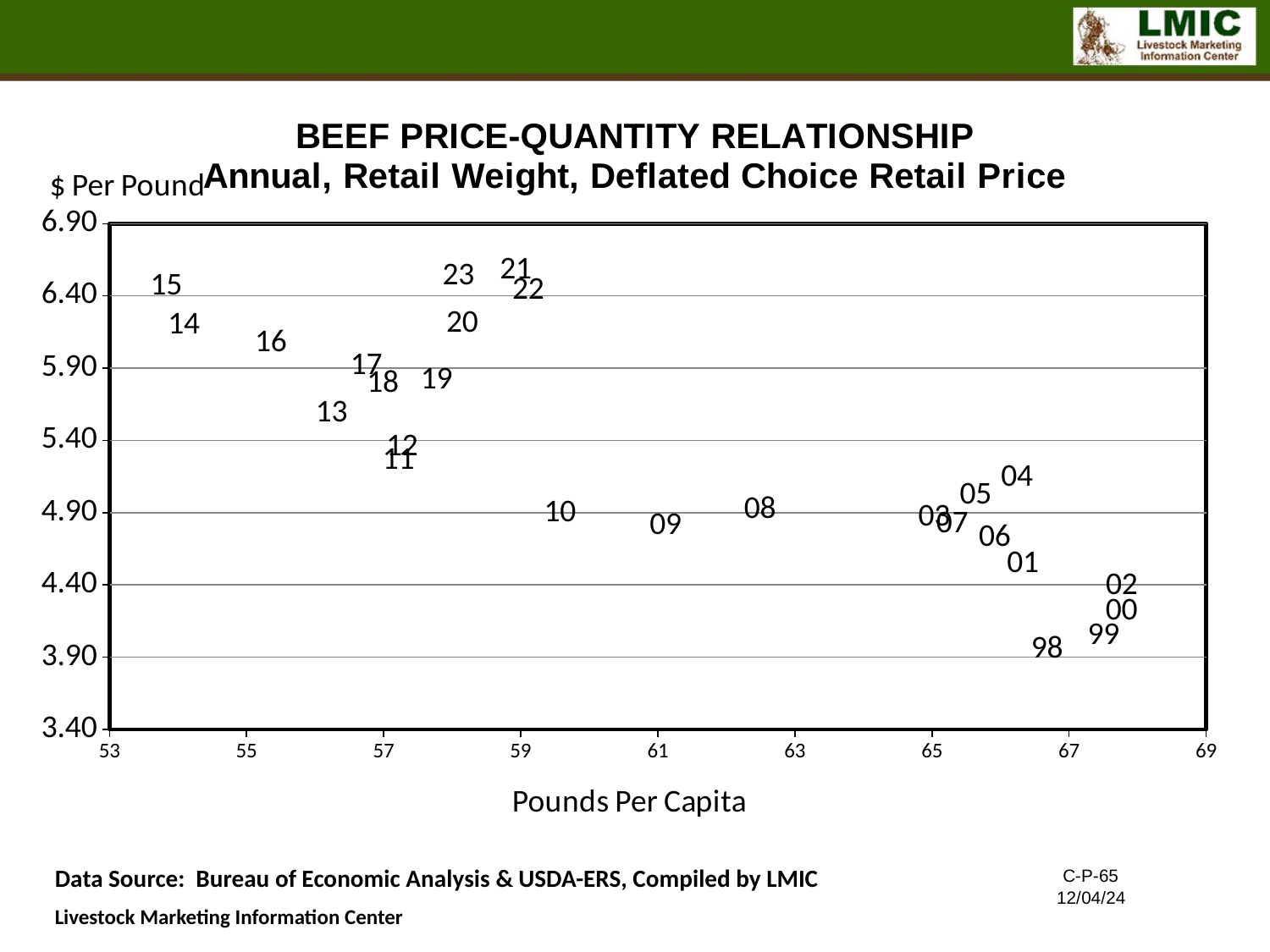
What is the title of the chart? BEEF PRICE-QUANTITY RELATIONSHIP Annual, Retail Weight, Deflated Choice Retail Price What kind of chart is shown on the slide? scatter chart Which year point has the lowest price ($ per pound)? 98 Which has the higher price, year 15 or year 98? 15 Is the price for year 13 greater or less than 5.40? greater How many year points are plotted on the chart? 26 As pounds per capita increase along the x axis, do prices generally rise or fall? fall Is the price for year 20 greater or less than 5.90? greater Is the price for year 99 greater or less than 4.40? less What is the label of the x axis? Pounds Per Capita Which year point has the highest price ($ per pound)? 21